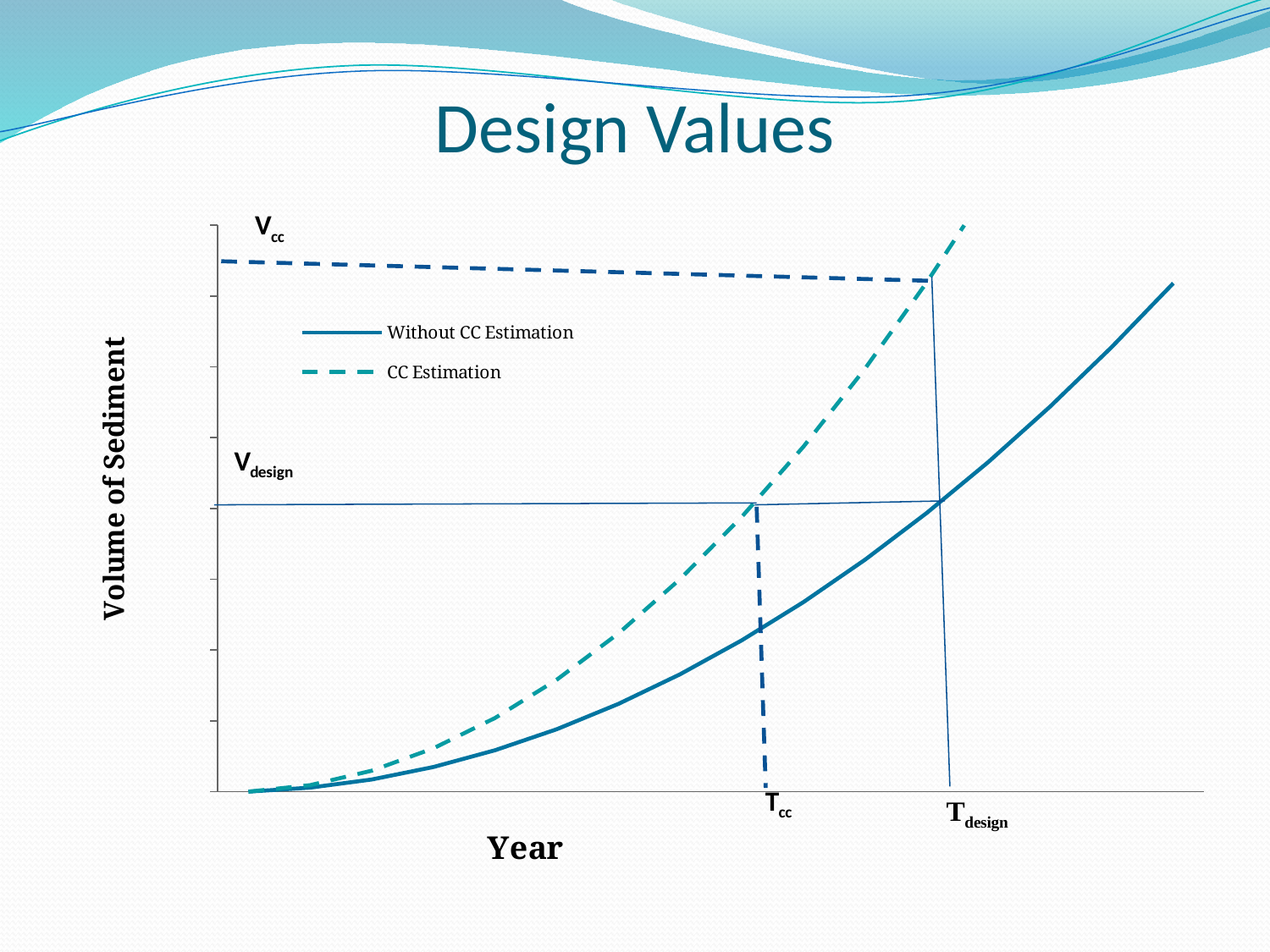
At year T_cc, which series has the higher volume of sediment, CC Estimation or Without CC Estimation? CC Estimation Which series reaches the V_design level first, CC Estimation or Without CC Estimation? CC Estimation Which series is drawn with a dashed line? CC Estimation At year T_design, which series has the higher volume of sediment, CC Estimation or Without CC Estimation? CC Estimation How many series does the legend list? 2 What is the title of the chart? Design Values What kind of chart is shown on the slide? Line chart Do the values of the Without CC Estimation series rise or fall along the x axis? Rise Do the values of the CC Estimation series rise or fall along the x axis? Rise What is the label of the y axis? Volume of Sediment